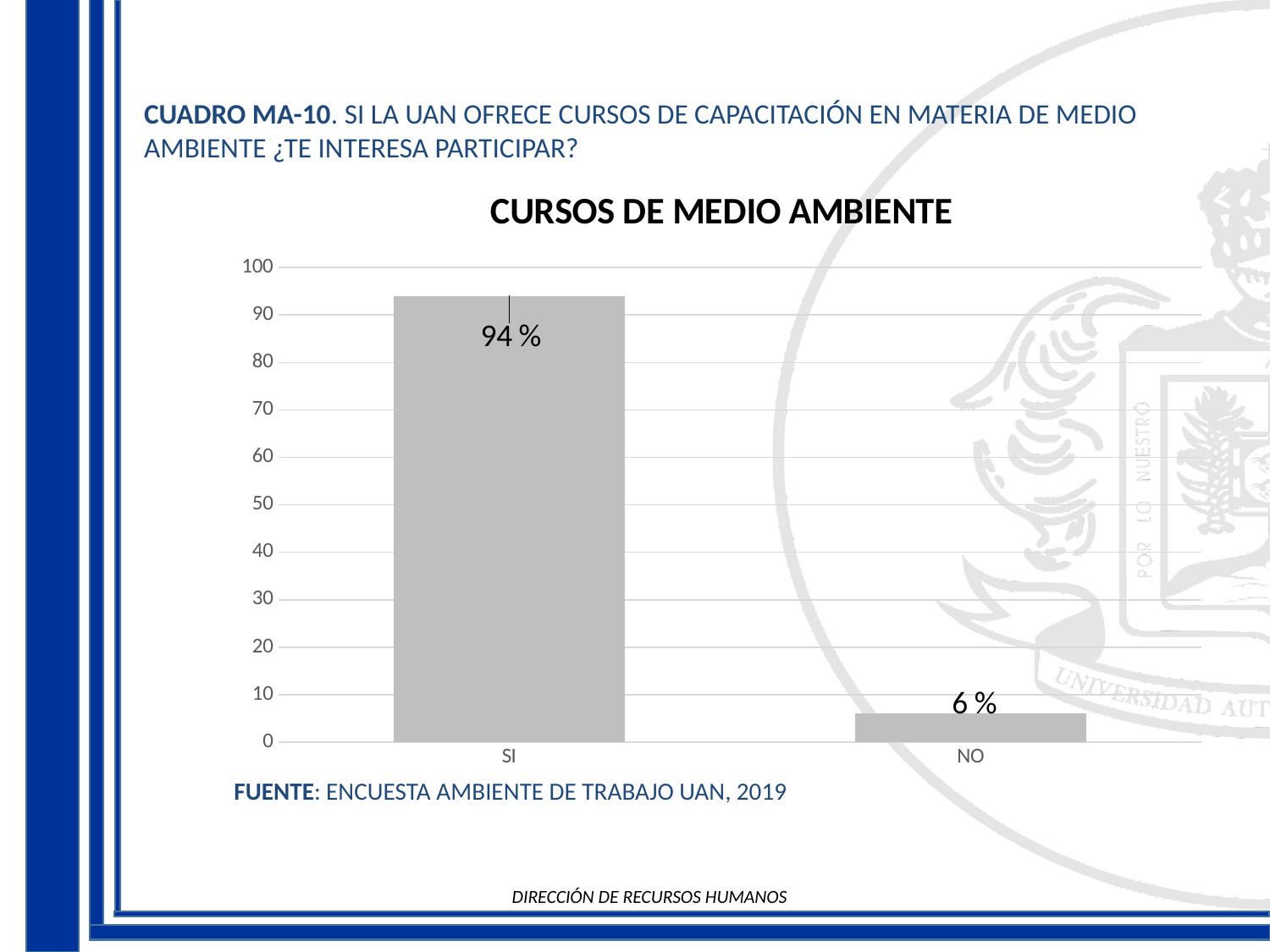
What is the maximum value shown on the y axis? 100 Which category has the lowest value? NO What is the value for NO? 6 % Is the value for SI greater or less than 90? greater Which is larger, the value for SI or the value for NO? SI How many categories are shown on the x axis? 2 What is the difference between the values for SI and NO? 88 % Is the value for NO greater or less than 10? less What is the value for SI? 94 % What kind of chart is this? bar chart What is the title of the chart? CURSOS DE MEDIO AMBIENTE Which category has the highest value? SI